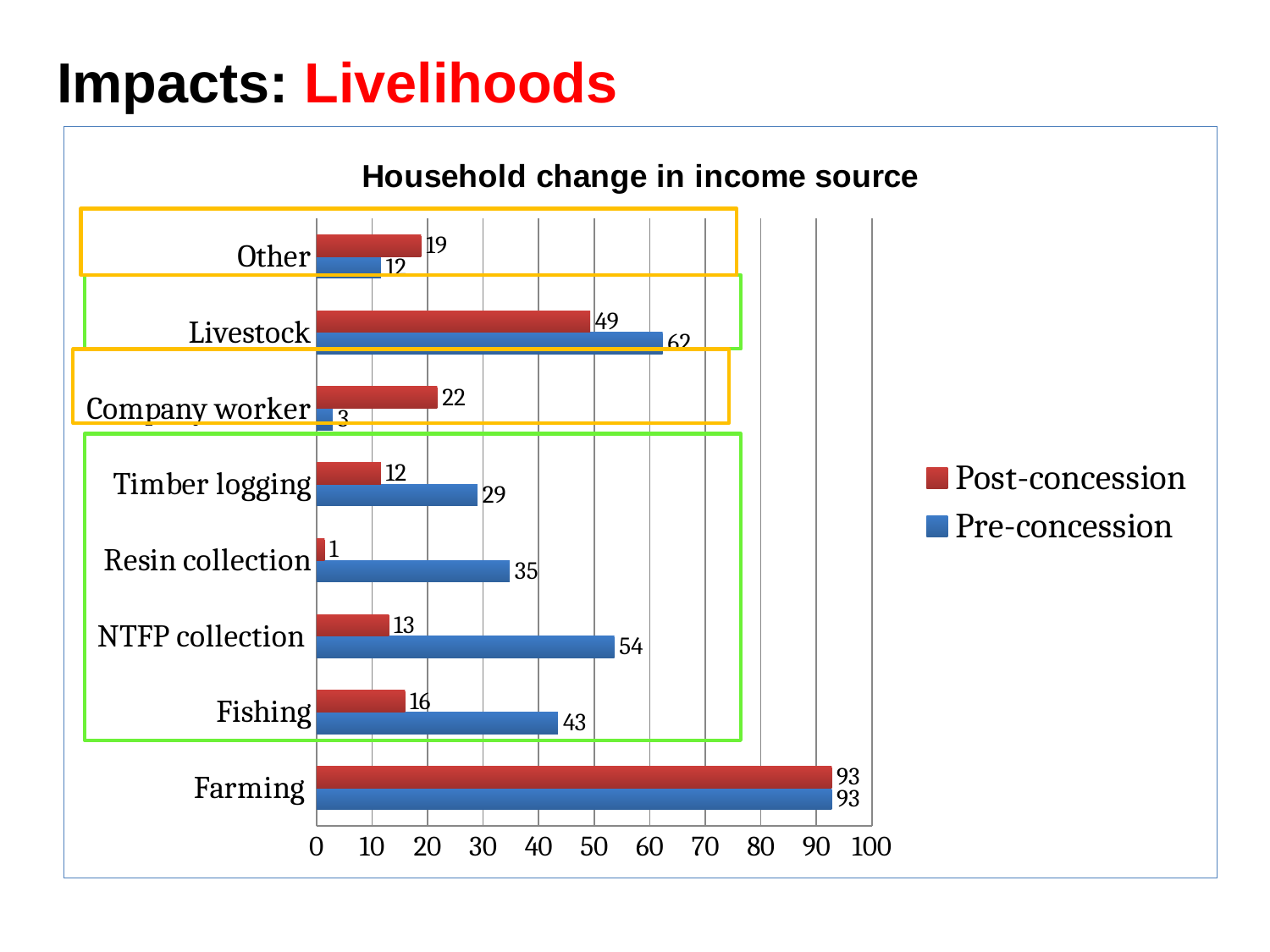
For Timber logging, which is larger: the Pre-concession or the Post-concession value? Pre-concession What is the Post-concession value for Resin collection? 1 How many income source categories are shown on the chart? 8 Which category has the highest Pre-concession value? Farming What is the difference between the Pre-concession and Post-concession values for Fishing? 27 What is the chart's title? Household change in income source Which category has the lowest Post-concession value? Resin collection How many series does the legend list? 2 What type of chart is shown on the slide? bar chart Is the Pre-concession value for Livestock greater or less than 50? greater What is the Post-concession value for Company worker? 22 What is the Pre-concession value for NTFP collection? 54